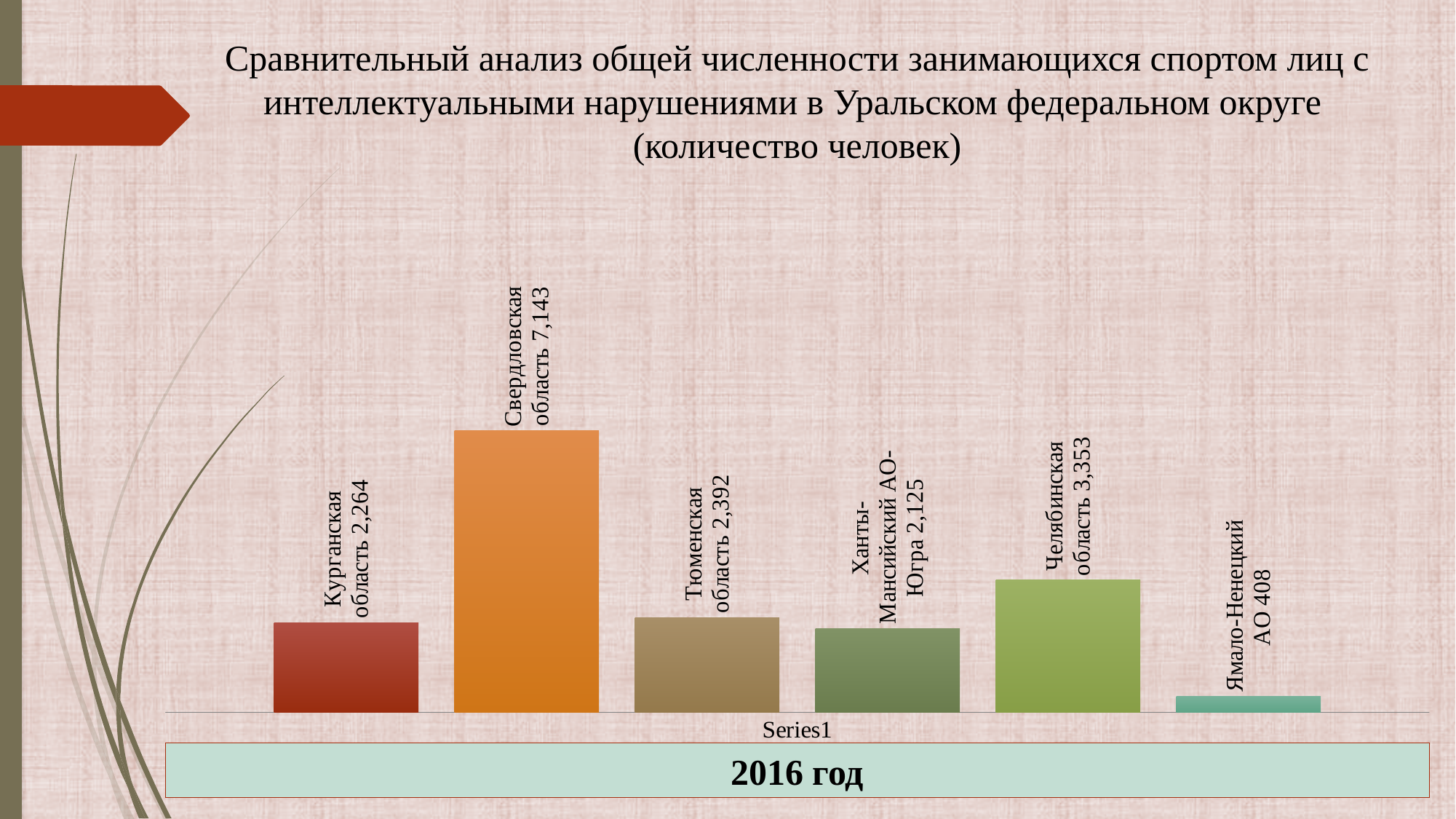
Which is larger, the value for Курганская область or the value for Ханты-Мансийский АО-Югра? Курганская область What is the value for Челябинская область? 3,353 What is the difference between the values for Свердловская область and Челябинская область? 3,790 How many regions (bars) are shown in the chart? 6 What kind of chart is shown on the slide? Bar chart What is the value for Ямало-Ненецкий АО? 408 Which year does the chart refer to, according to the label below the chart? 2016 год What is the value for Ханты-Мансийский АО-Югра? 2,125 What is the value for Свердловская область? 7,143 What is the difference between the values for Тюменская область and Курганская область? 128 Which region has the lowest value? Ямало-Ненецкий АО Which region has the highest value? Свердловская область